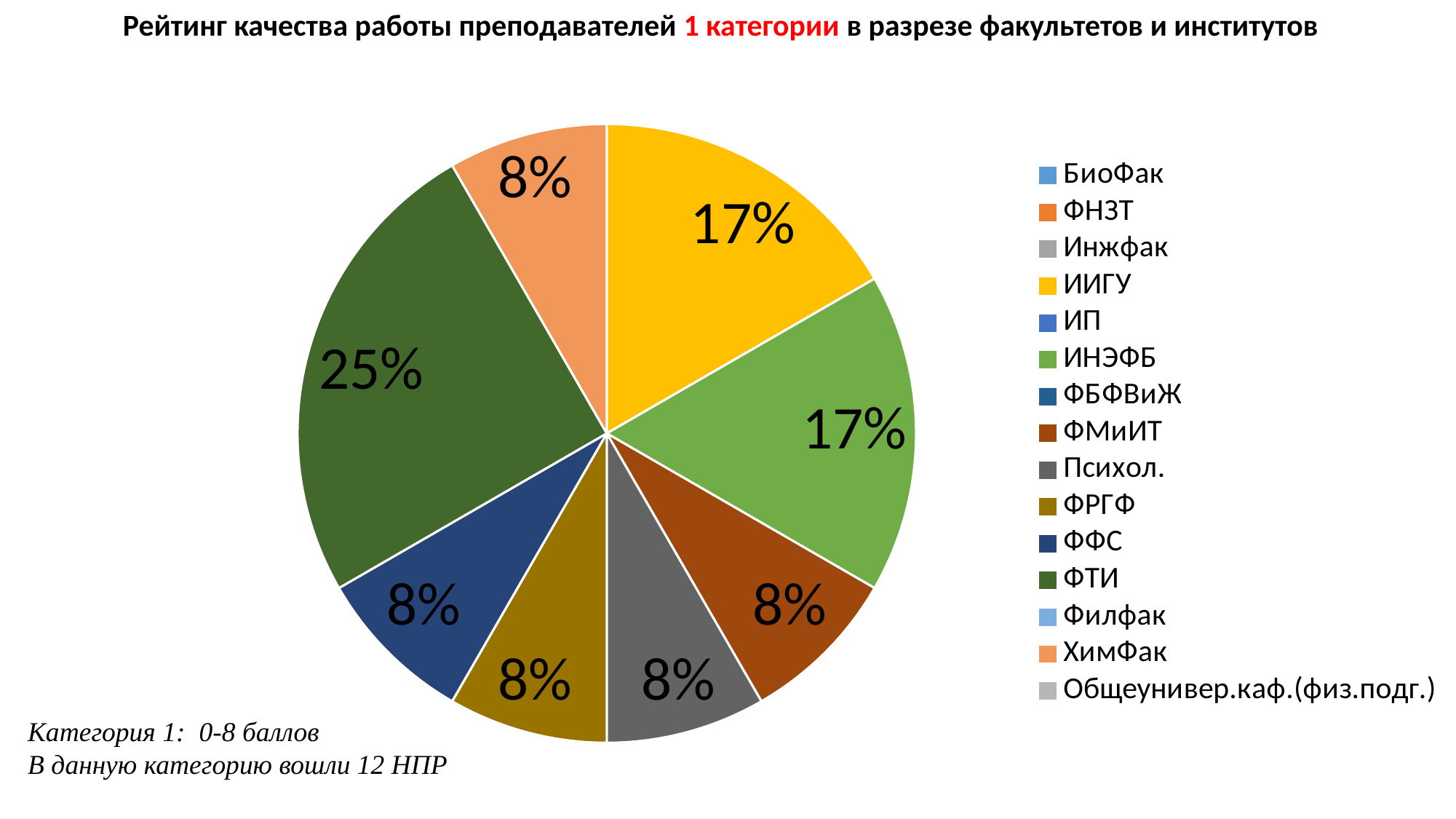
How many entries does the legend list? 15 What is the value shown for ИИГУ? 17% Which is larger, the share of ФТИ or the share of ФФС? ФТИ How many slices does the pie chart have? 8 Which legend entry is shown in yellow? ИИГУ What is the difference between the shares of ФТИ and ИИГУ? 8 percentage points What is the value shown for ИНЭФБ? 17% What kind of chart is shown on the slide? pie chart Which faculty has the largest slice of the pie? ФТИ What is the value shown for ФФС? 8% What share of the pie does ФТИ have? 25% What is the value shown for ХимФак? 8%